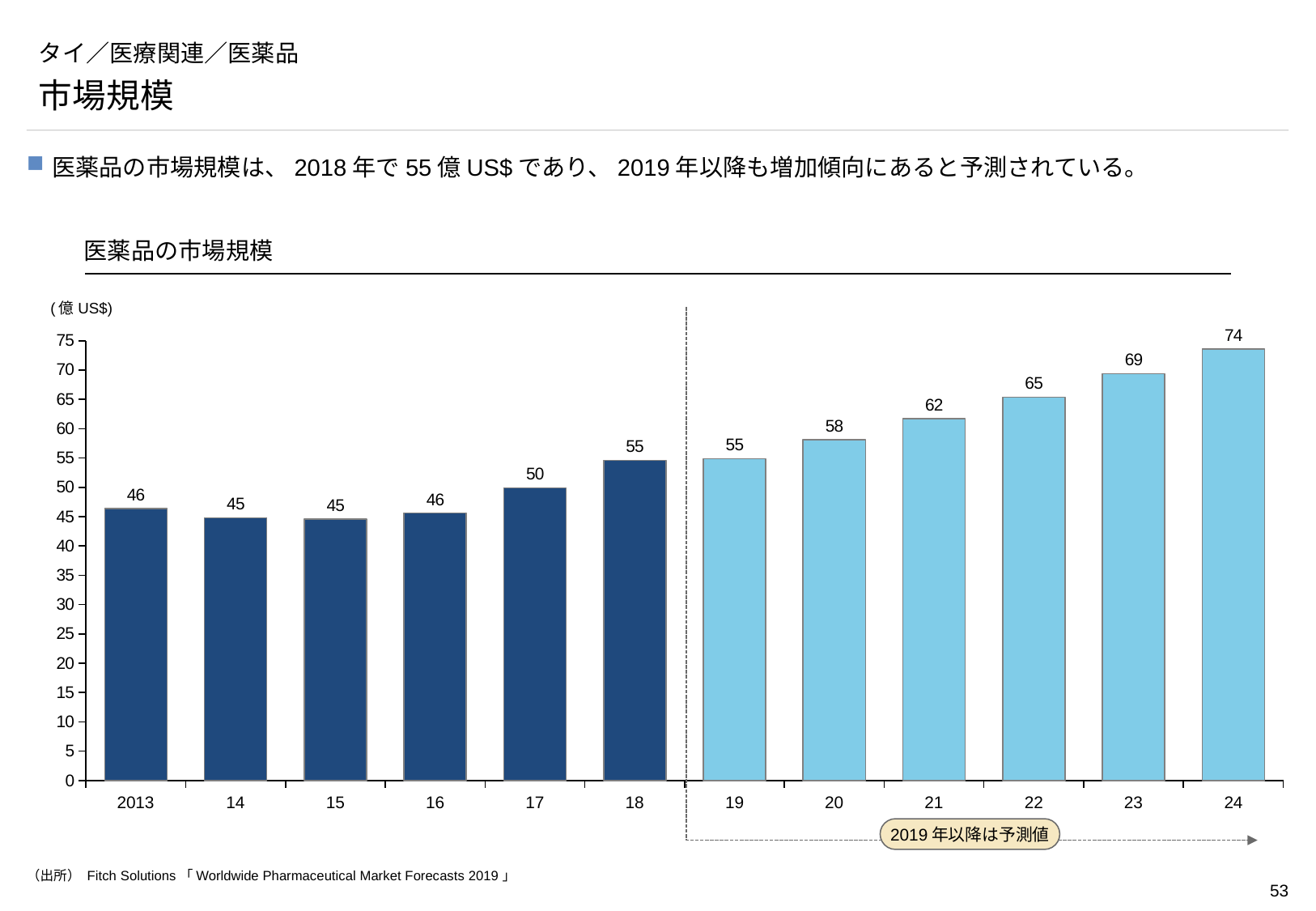
What is the value for 2018 in the 医薬品の市場規模 chart? 55 Which is larger in the 医薬品の市場規模 chart, the value for 2019 or the value for 2022? 2022 What kind of chart is the 医薬品の市場規模 chart? bar chart What is the difference between the values for 2024 and 2018 in the 医薬品の市場規模 chart? 19 Which year has the highest value in the 医薬品の市場規模 chart? 24 How many years are shown on the x axis of the 医薬品の市場規模 chart? 12 Is the value for 2023 in the 医薬品の市場規模 chart greater or less than 60? greater What is the value for 2024 in the 医薬品の市場規模 chart? 74 Do the values in the 医薬品の市場規模 chart rise or fall from 2018 to 2024? rise What is the value for 2021 in the 医薬品の市場規模 chart? 62 What is the difference between the values for 2017 and 2016 in the 医薬品の市場規模 chart? 4 What unit is shown on the y axis of the 医薬品の市場規模 chart? 億 US$